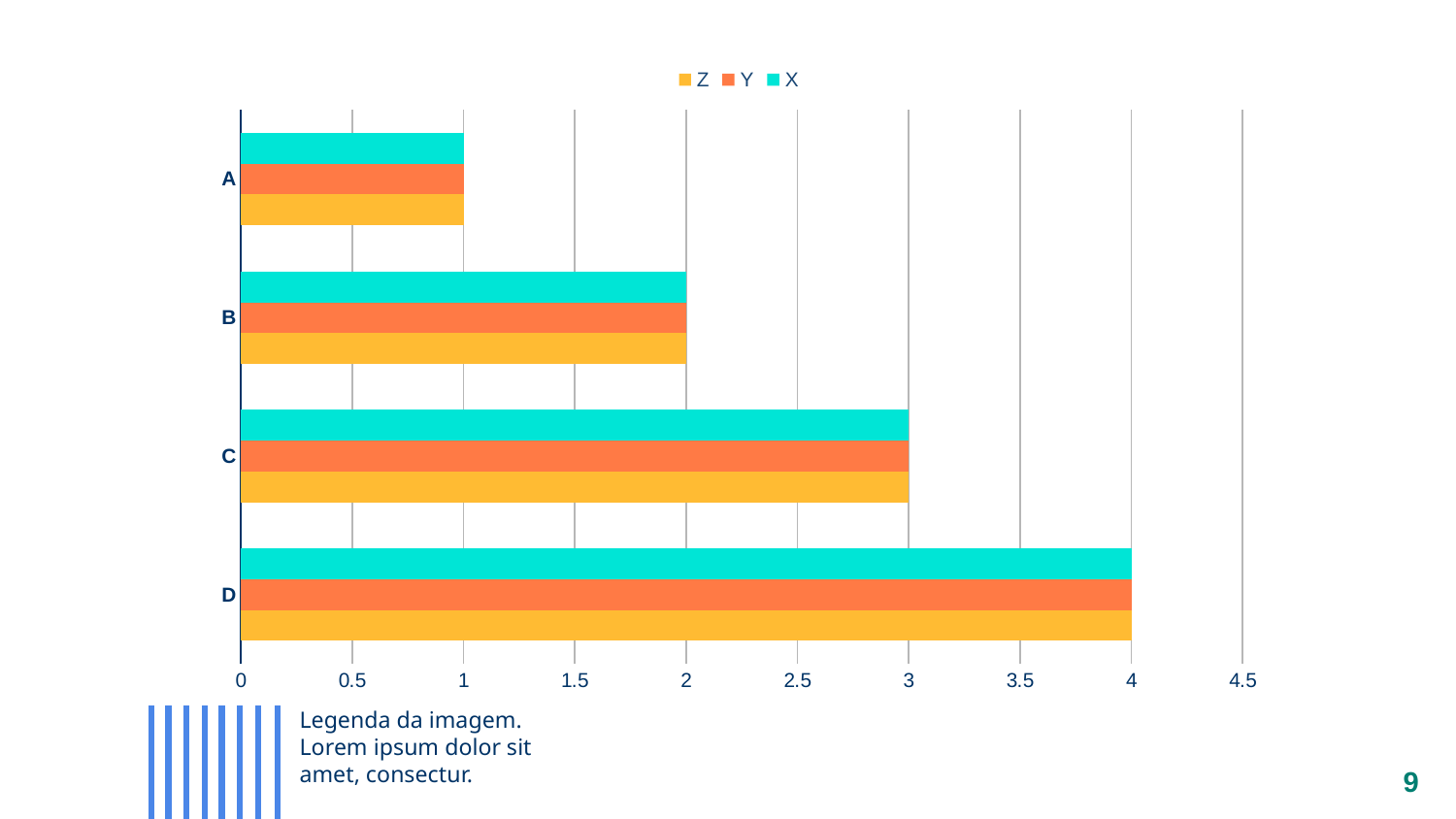
What is the difference between the series Y value for D and the series Y value for A? 3 What is the value of series X for category D? 4 What is the value of series Y for category B? 2 Is the value of series Z for category D greater or less than 3.5? greater How many series does the legend list? 3 What is the value of series Z for category C? 3 Which category has the lowest value for series X? A Which is larger, the series X value for C or the series X value for B? C Which category has the highest value for series Z? D Which series is shown in orange in the legend? Y How many categories are shown on the vertical axis? 4 What kind of chart is shown on the slide? bar chart